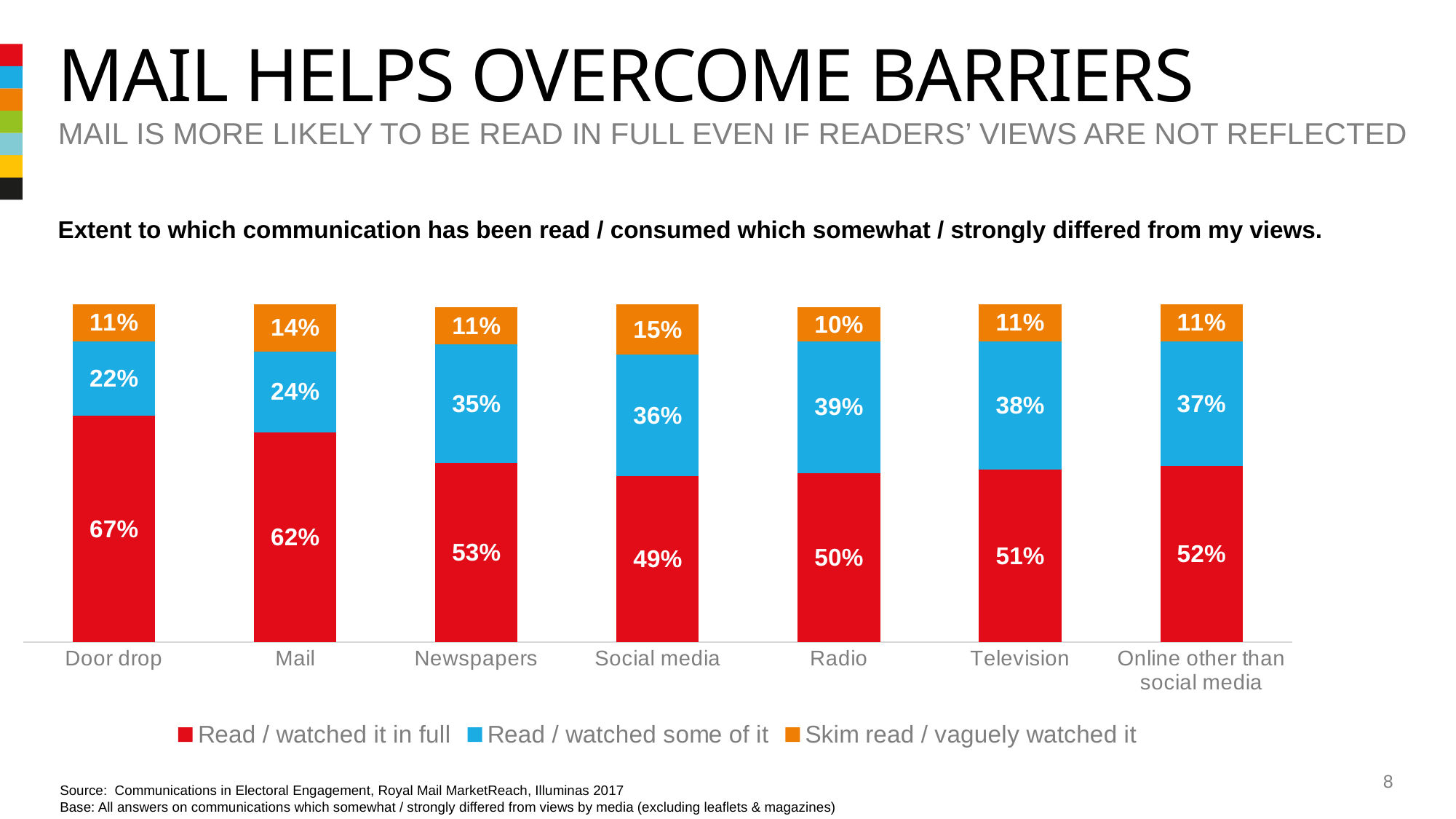
What kind of chart is shown on the slide? Stacked bar chart How many categories are shown on the x axis? 7 What is the 'Read / watched some of it' value for Radio? 39% What is the total of the stacked bar for Mail? 100% Which colour represents 'Skim read / vaguely watched it' in the legend? Orange What percentage of Door drop communications were read / watched in full? 67% Which category has the highest 'Read / watched it in full' value? Door drop What is the 'Skim read / vaguely watched it' value for Social media? 15% How many series does the legend list? 3 Which is larger: the 'Read / watched some of it' value for Television or for Mail? Television Which category has the lowest 'Read / watched it in full' value? Social media What is the difference between the 'Read / watched it in full' values for Mail and Newspapers? 9%